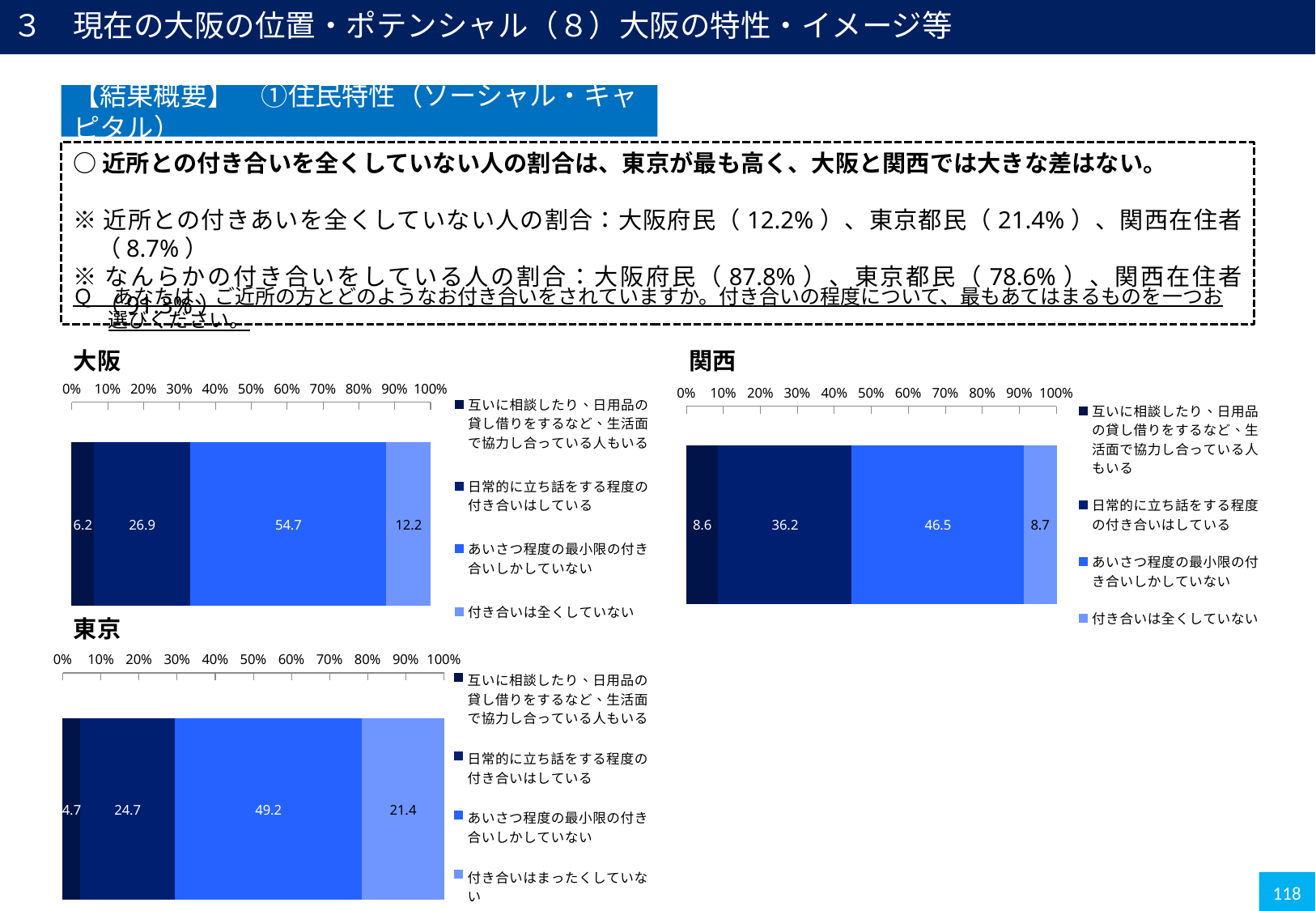
Which is larger: the あいさつ程度の最小限の付き合いしかしていない value in the 大阪 chart or in the 関西 chart? 大阪 How many series does the legend of the 関西 chart list? 4 In the 関西 chart, what is the value for 互いに相談したり、日用品の貸し借りをするなど、生活面で協力し合っている人もいる? 8.6 In the 大阪 chart, which segment has the largest value? あいさつ程度の最小限の付き合いしかしていない What is the difference between the 付き合いは全くしていない value in the 東京 chart (21.4) and in the 大阪 chart (12.2)? 9.2 In the 東京 chart, what is the value for あいさつ程度の最小限の付き合いしかしていない? 49.2 In the 関西 chart, what is the value for 日常的に立ち話をする程度の付き合いはしている? 36.2 What is the total of the stacked bar in the 関西 chart? 100 In the 東京 chart, which segment has the smallest value? 互いに相談したり、日用品の貸し借りをするなど、生活面で協力し合っている人もいる How many charts are shown on the slide? 3 What kind of chart is the 東京 chart? Stacked bar chart In the 大阪 chart, what is the value for 付き合いは全くしていない? 12.2